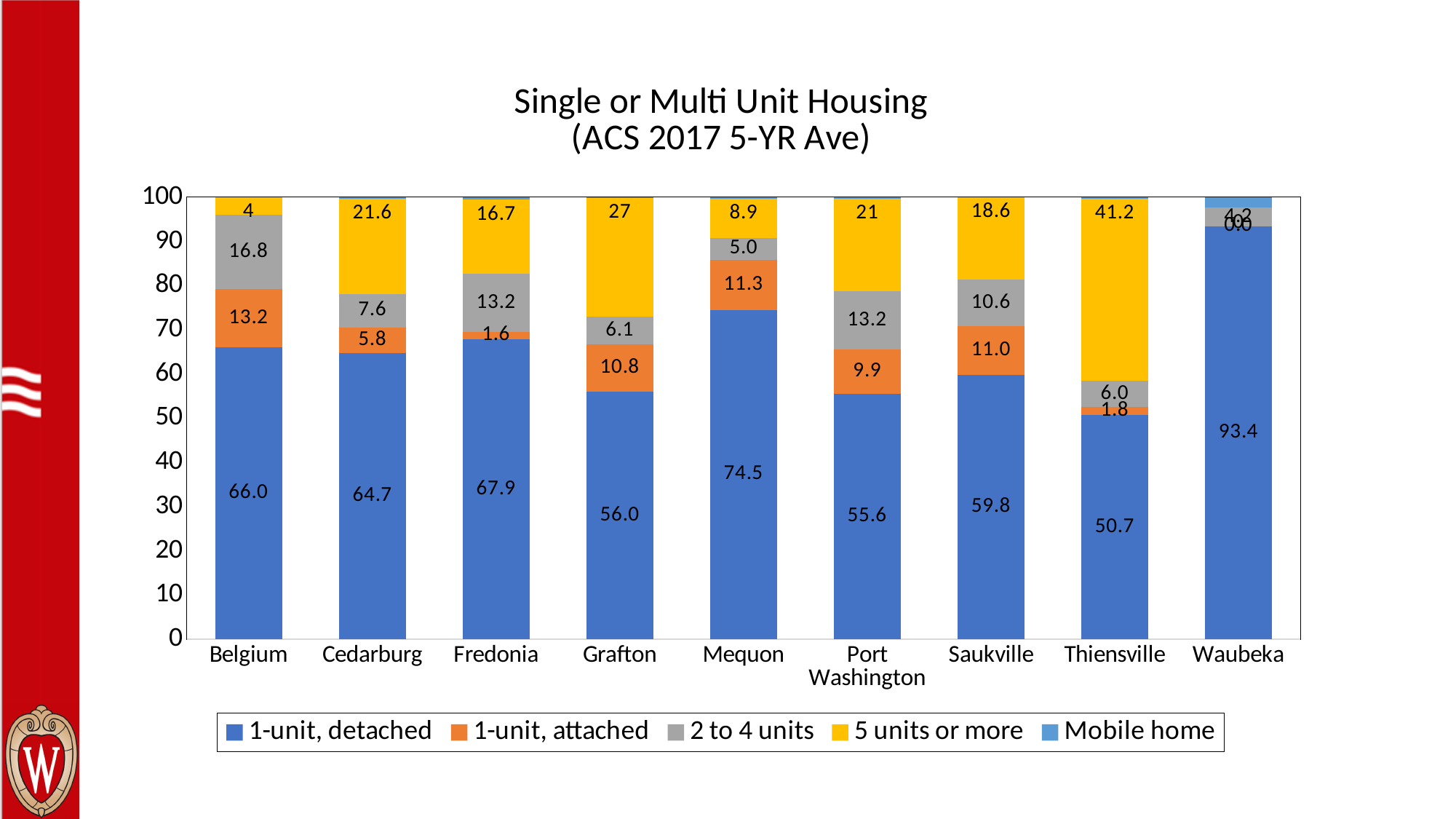
What is the value for 5 units or more in Thiensville? 41.2 What is the difference between the 1-unit, detached values for Mequon and Grafton? 18.5 What is the value for 1-unit, attached in Fredonia? 1.6 What is the value for 2 to 4 units in Belgium? 16.8 What is the value for 1-unit, detached in Mequon? 74.5 What kind of chart is shown on the slide? Stacked bar chart Which community has the highest value for 1-unit, detached? Waubeka How many communities are shown on the x axis? 9 Which community has the highest value for 5 units or more? Thiensville How many series does the legend list? 5 Which is larger, the 5 units or more value for Cedarburg or for Port Washington? Cedarburg Which community has the lowest value for 1-unit, detached? Thiensville